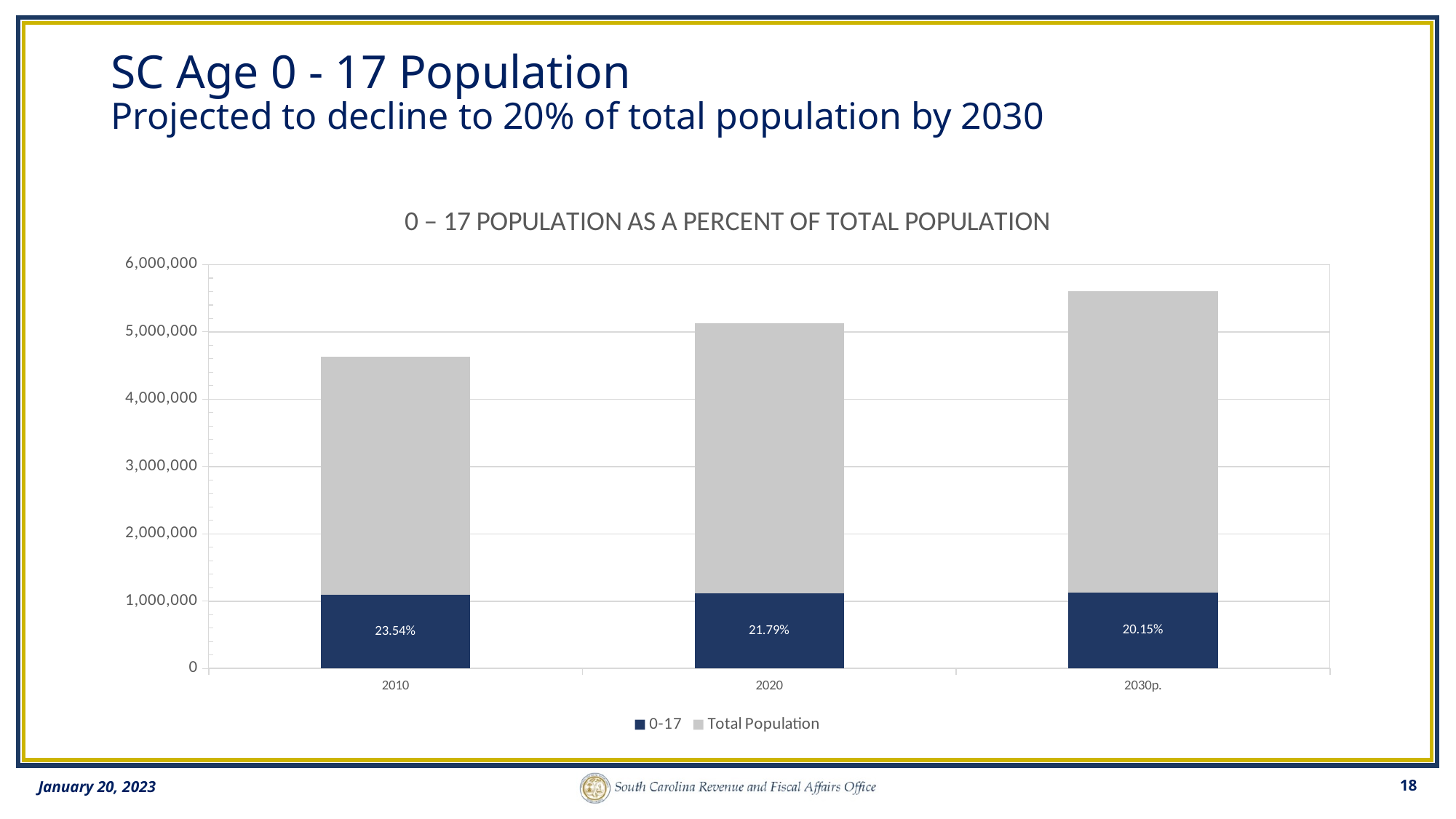
Which year has the tallest total bar? 2030p. What percentage label is shown on the 0-17 segment for 2010? 23.54% How many years are shown on the x axis? 3 How many series does the legend list? 2 Is the total bar height for 2010 greater or less than 5,000,000? less Is the total bar height for 2030p. greater or less than 5,000,000? greater Is the total bar for 2010 taller or shorter than the total bar for 2030p.? shorter What percentage label is shown on the 0-17 segment for 2030p.? 20.15% What kind of chart is shown on the slide? stacked bar chart Which year has the shortest total bar? 2010 By how many percentage points does the 0-17 share label for 2010 exceed the label for 2030p.? 3.39 percentage points What percentage label is shown on the 0-17 segment for 2020? 21.79%